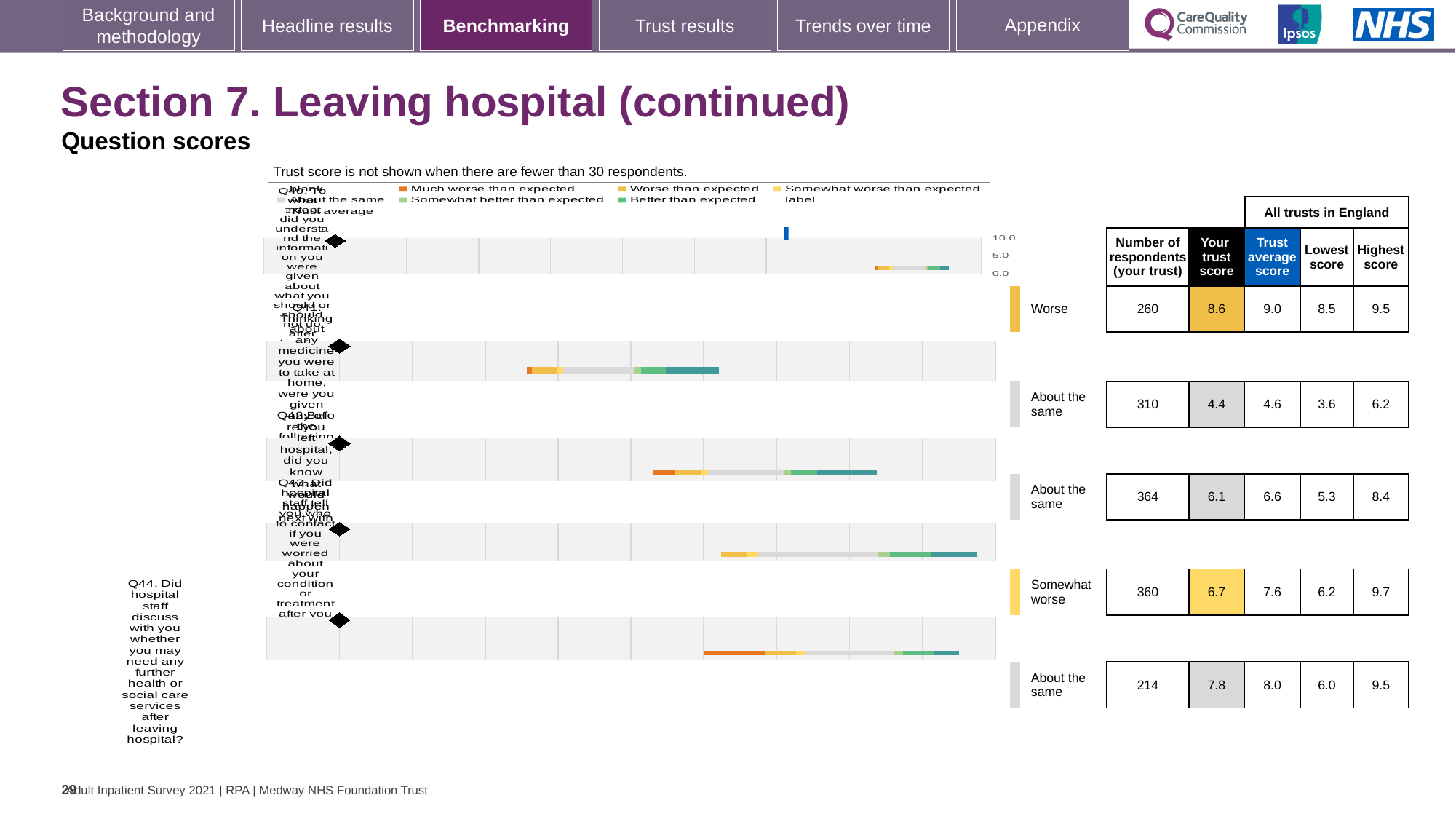
What kind of chart is used to show the question scores on this slide? bar chart What is the largest number of respondents shown in the table? 364 In the first row of the table, which is larger: your trust score or the trust average score? Trust average score What is the number of respondents for the first row of the table? 260 What is the lowest score (all trusts in England) for the second row of the table? 3.6 What is the trust average score for the row rated 'Somewhat worse'? 7.6 What is the highest score (all trusts in England) for the fourth row of the table? 9.7 How many rows in the table are rated 'About the same'? 3 What is the 'Your trust score' for Q44 (the last row of the table)? 7.8 For Q44 (the last row), what is the difference between the trust average score and your trust score? 0.2 How many question rows (bars) are shown in the chart? 5 What is the lowest 'Your trust score' shown in the table? 4.4